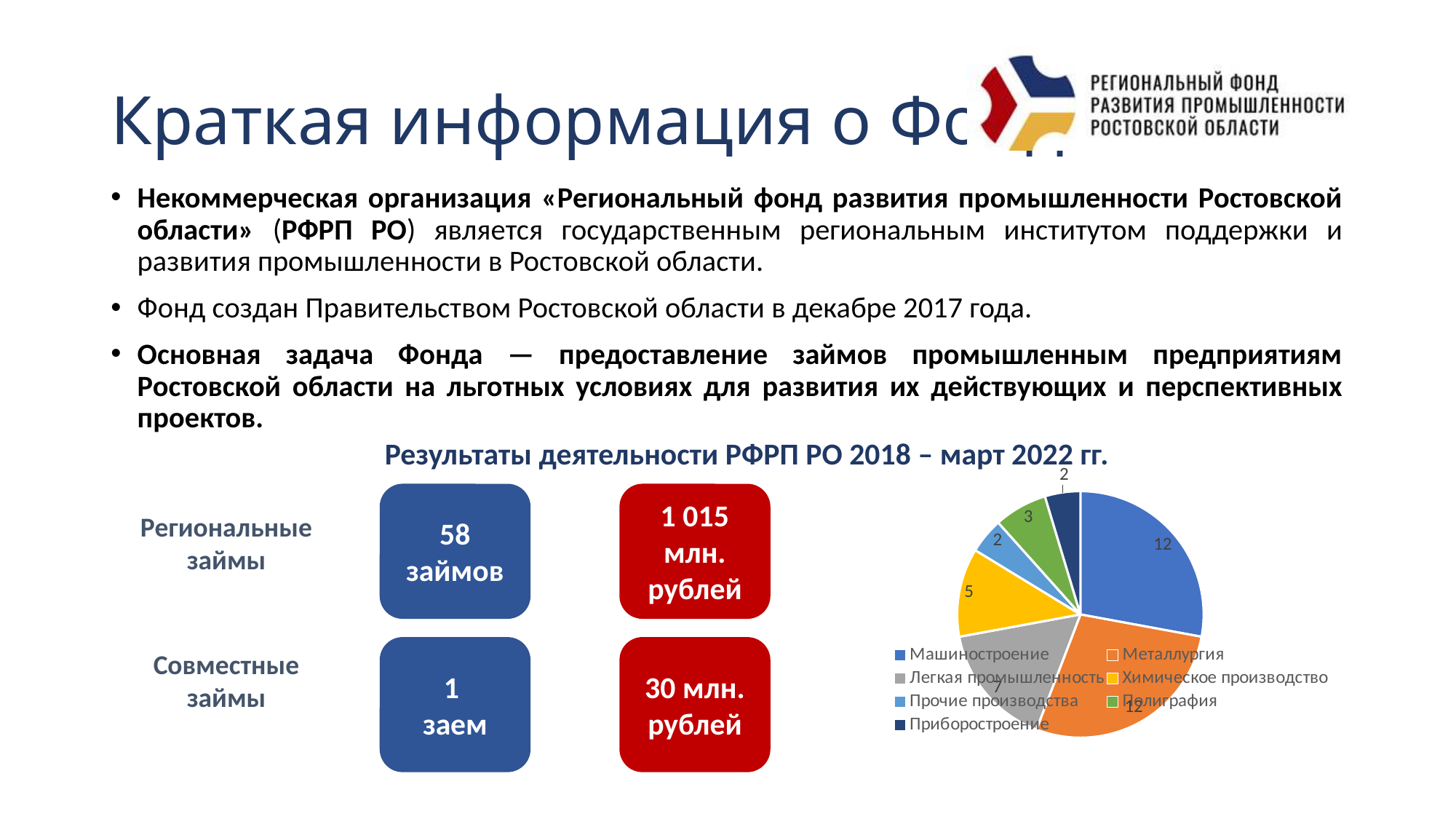
What is the value for Химическое производство in the pie chart? 5 What is the value for Приборостроение in the pie chart? 2 What kind of chart is shown on the slide? pie chart What is the value for Металлургия in the pie chart? 12 What is the value for Полиграфия in the pie chart? 3 How many categories does the legend of the pie chart list? 7 What is the value for Машиностроение in the pie chart? 12 Which is larger in the pie chart: Машиностроение or Полиграфия? Машиностроение Which is larger in the pie chart: Химическое производство or Полиграфия? Химическое производство What is the difference between the values for Машиностроение and Химическое производство in the pie chart? 7 What is the difference between the values for Металлургия and Приборостроение in the pie chart? 10 Which legend entry of the pie chart is shown in green? Полиграфия